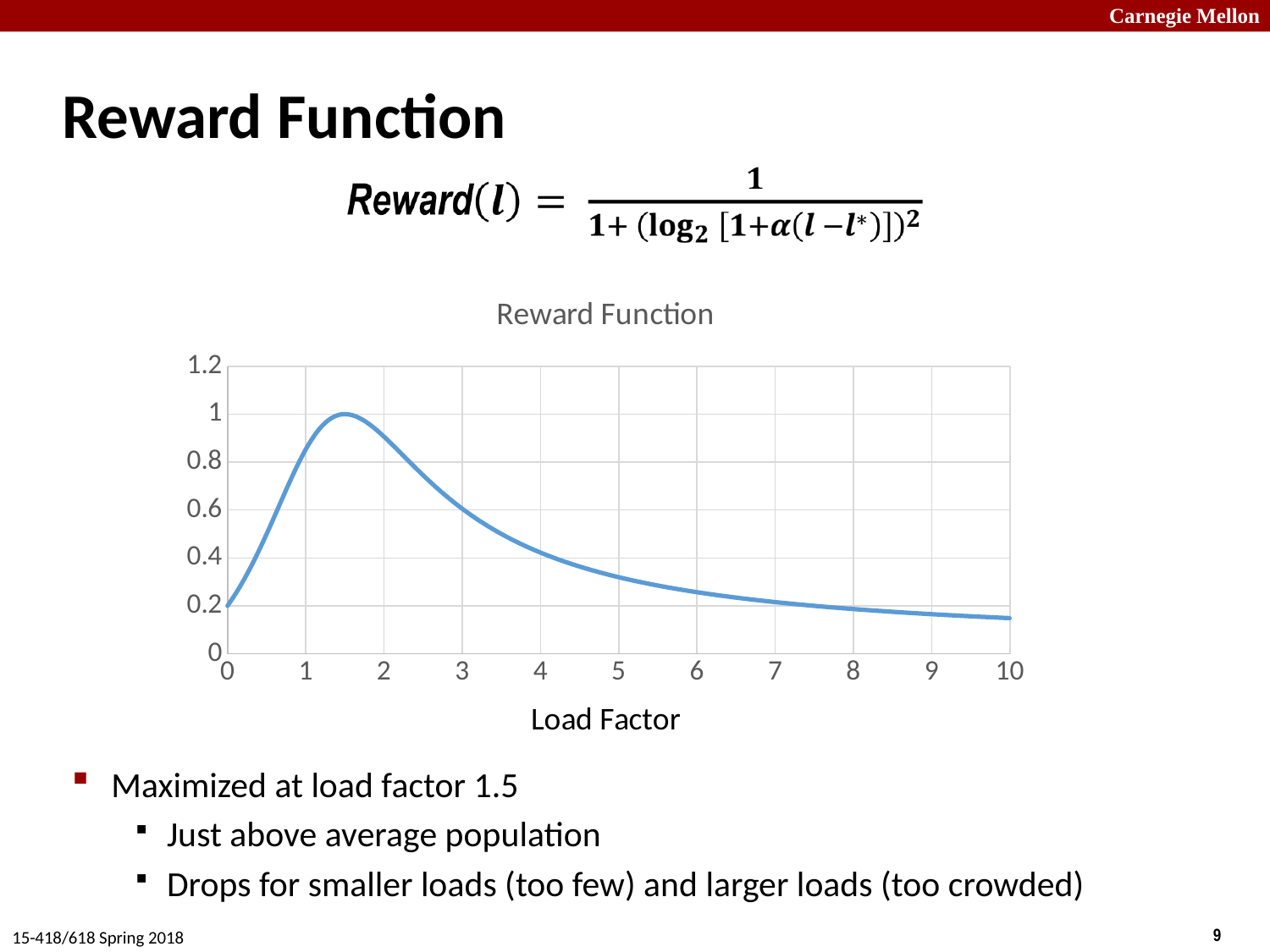
What is the label of the x axis of the chart? Load Factor Is the reward value at load factor 2 greater or less than 0.6? greater Does the reward curve rise or fall as the load factor increases from 2 to 10? fall Which has the larger reward value: load factor 1 or load factor 8? load factor 1 Is the reward value at load factor 1 greater or less than 0.6? greater Is the reward value at load factor 10 greater or less than 0.2? less What is the highest value shown on the y axis of the chart? 1.2 At what load factor is the reward function maximized? 1.5 What is the maximum value of the reward curve, as read from the y axis tick it reaches? 1 What kind of chart is shown on the slide? line chart What is the title of the chart? Reward Function